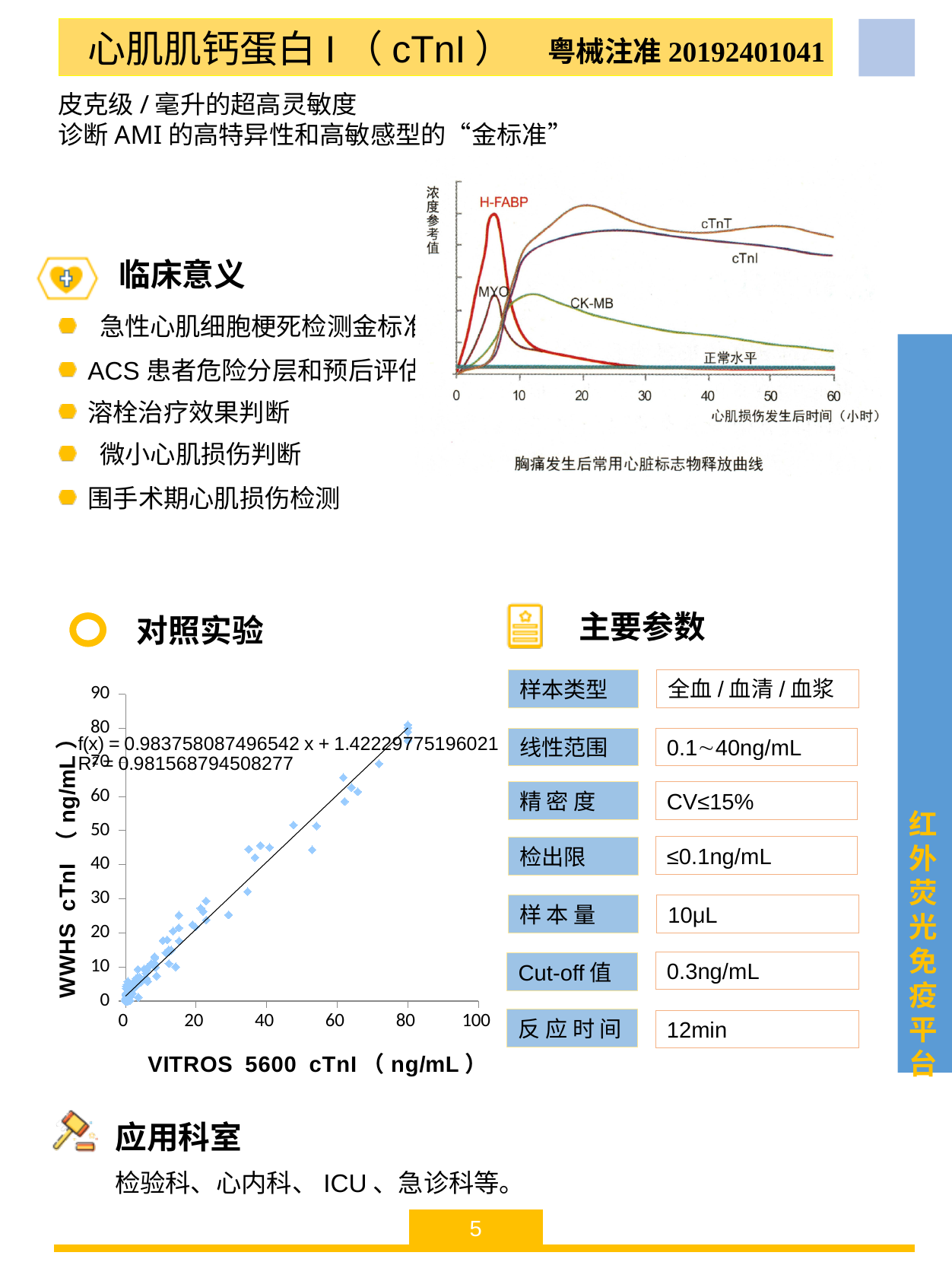
In the 对照实验 scatter chart, what is the label of the y axis? WWHS cTnI（ng/mL） In the 对照实验 scatter chart, do the plotted points rise or fall as the x-axis value increases? rise In the 对照实验 scatter chart, what is the label of the x axis? VITROS 5600 cTnI（ng/mL） In the 胸痛发生后常用心脏标志物释放曲线 line chart, how many cardiac marker curves are labelled (excluding the 正常水平 line)? 5 In the 对照实验 scatter chart, what is the slope of the fitted line f(x) printed on the chart? 0.983758087496542 In the 胸痛发生后常用心脏标志物释放曲线 line chart, what is the label of the x axis? 心肌损伤发生后时间（小时） In the 对照实验 scatter chart, what is the highest tick value shown on the x axis? 100 In the 胸痛发生后常用心脏标志物释放曲线 line chart, which marker reaches its peak earliest after myocardial injury? H-FABP In the 对照实验 scatter chart, what R² value is printed for the fitted line? 0.981568794508277 In the 对照实验 scatter chart, what is the highest tick value shown on the y axis? 90 In the 胸痛发生后常用心脏标志物释放曲线 line chart, what is the highest tick value on the x axis? 60 What kind of chart is the 对照实验 chart on the lower left of the slide? scatter chart